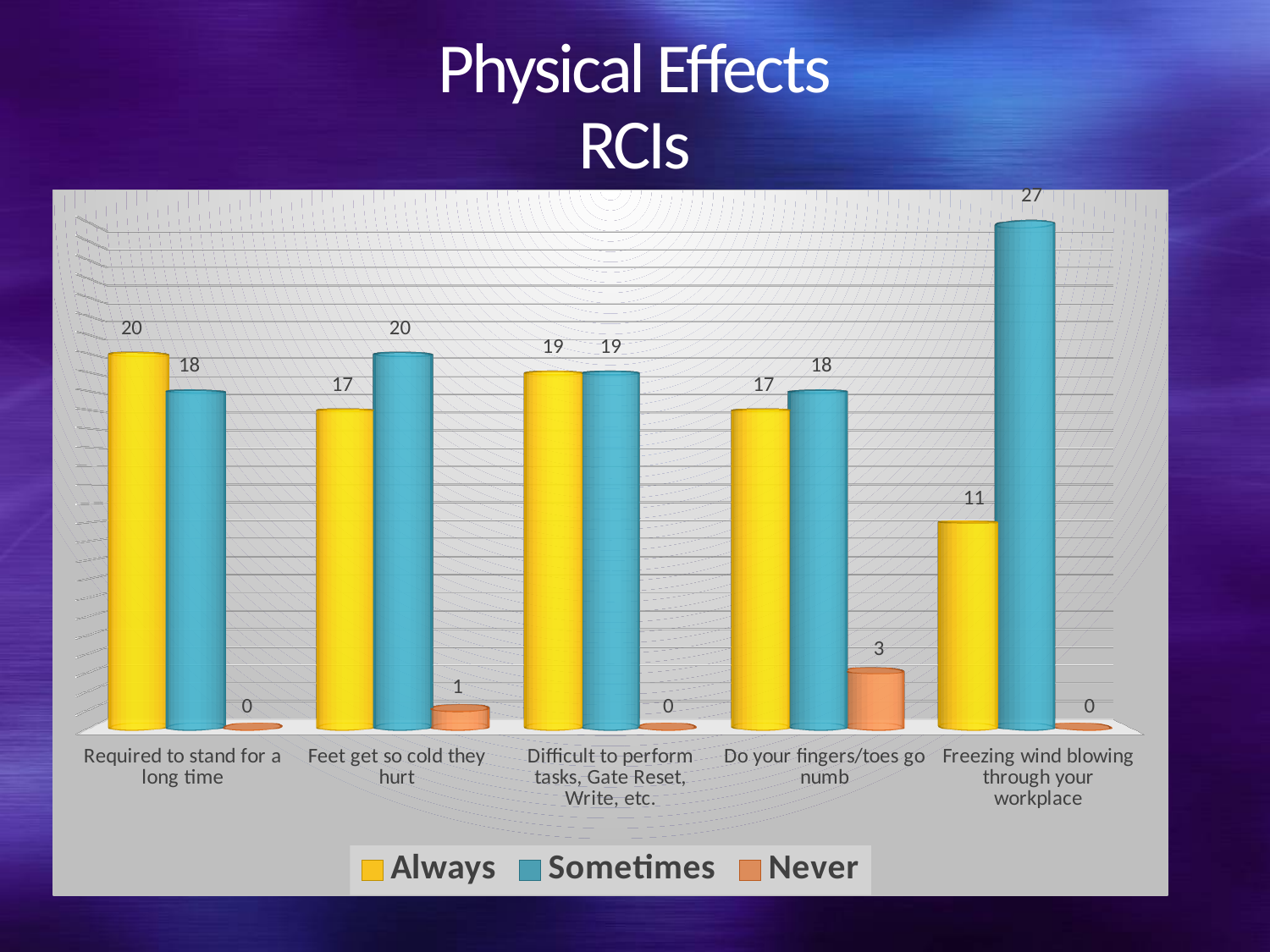
What is the title of the slide? Physical Effects RCIs What is the 'Always' value for 'Required to stand for a long time'? 20 What is the difference between the 'Sometimes' and 'Always' values for 'Freezing wind blowing through your workplace'? 16 How many series does the legend list? 3 What is the 'Always' value for 'Feet get so cold they hurt'? 17 How many categories are shown on the x axis? 5 What is the 'Sometimes' value for 'Freezing wind blowing through your workplace'? 27 For 'Required to stand for a long time', which is larger: the 'Always' value or the 'Sometimes' value? Always What is the 'Never' value for 'Do your fingers/toes go numb'? 3 What kind of chart is shown on the slide? Bar chart Which category has the highest 'Sometimes' value? Freezing wind blowing through your workplace Which category has the lowest 'Always' value? Freezing wind blowing through your workplace